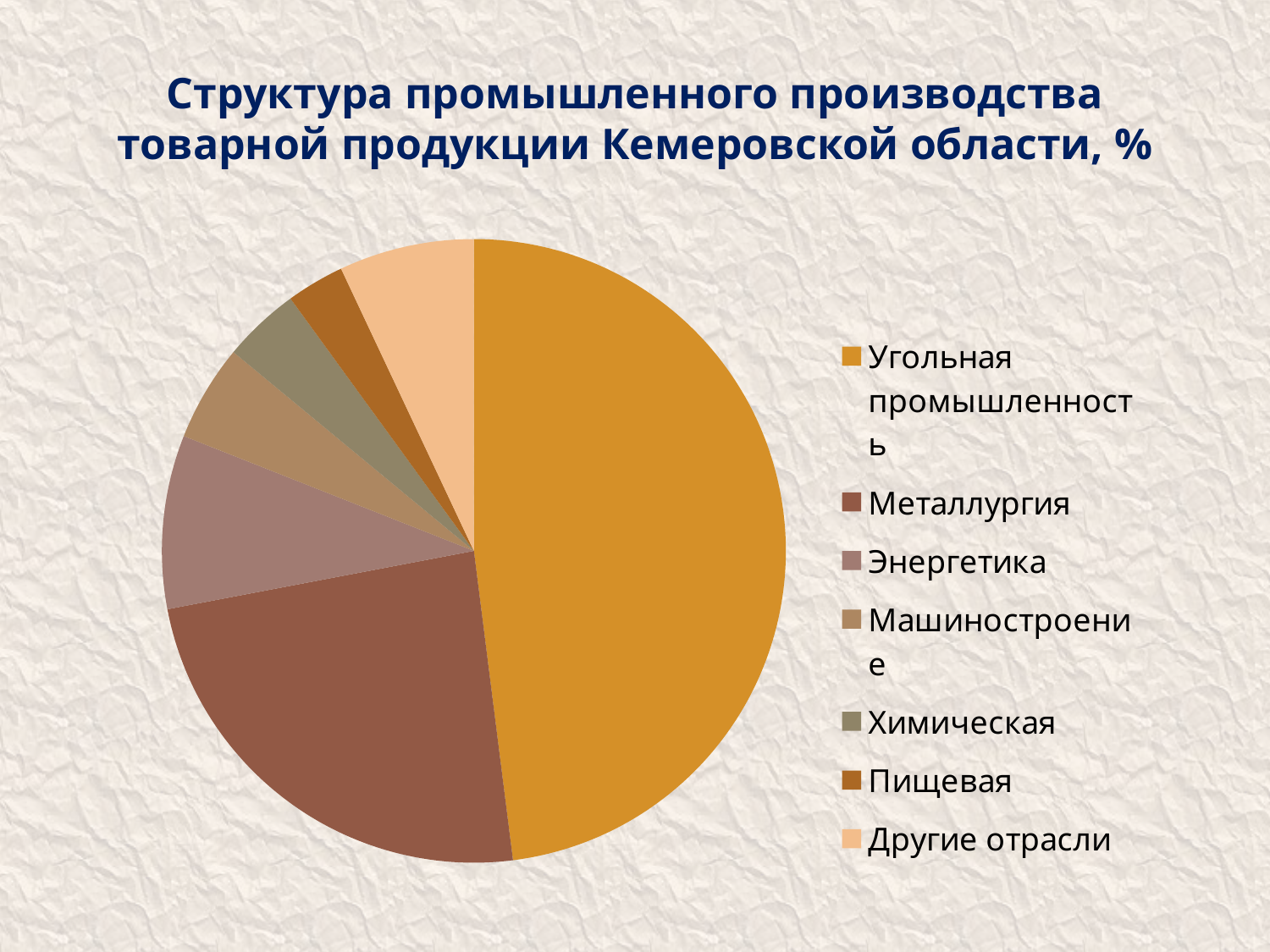
How many categories (slices) does the pie chart have? 7 What is the title of the chart? Структура промышленного производства товарной продукции Кемеровской области, % Which slice is larger, Энергетика or Химическая? Энергетика What kind of chart is shown on the slide? Pie chart Which slice is larger, Угольная промышленность or Металлургия? Угольная промышленность Which slice is larger, Металлургия or Энергетика? Металлургия Which legend entry is listed last in the legend? Другие отрасли Which category is the second largest slice of the pie? Металлургия Which category has the smallest slice of the pie? Пищевая Which category has the largest slice of the pie? Угольная промышленность